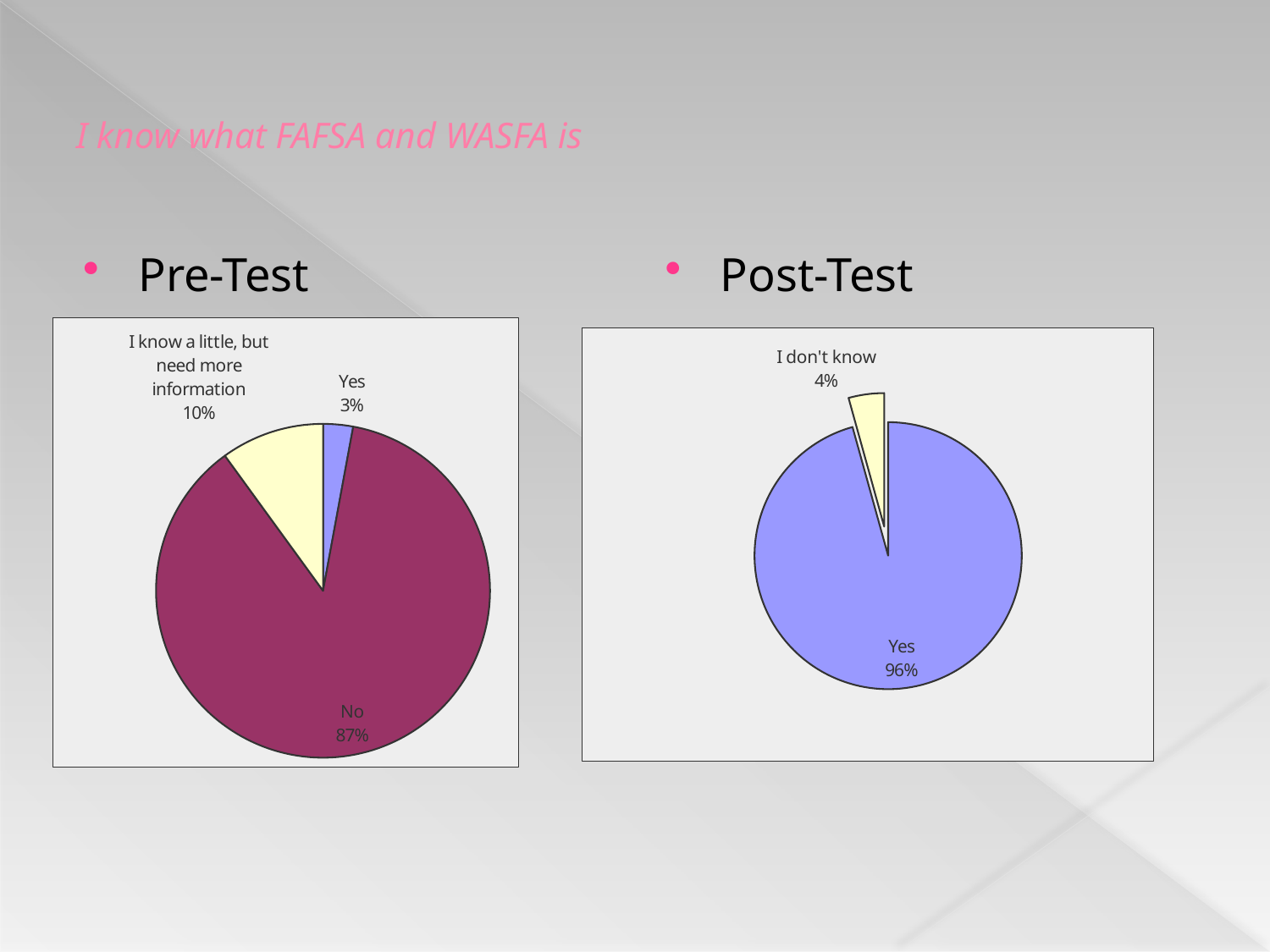
In the Pre-Test chart, which response has the largest slice? No What type of chart is the Post-Test chart? Pie chart In the Post-Test chart, what share is labelled "I don't know"? 4% In the Pre-Test chart, what percentage answered "Yes"? 3% In the Post-Test chart, what percentage answered "Yes"? 96% In the Pre-Test chart, how many slices does the pie have? 3 In the Post-Test chart, how many slices does the pie have? 2 In the Pre-Test chart, what percentage answered "No"? 87% In the Pre-Test chart, what share is labelled "I know a little, but need more information"? 10% In the Pre-Test chart, which response has the smallest slice? Yes What is the difference between the "Yes" percentage in the Post-Test chart and the "Yes" percentage in the Pre-Test chart? 93% In the Post-Test chart, which response has the largest slice? Yes